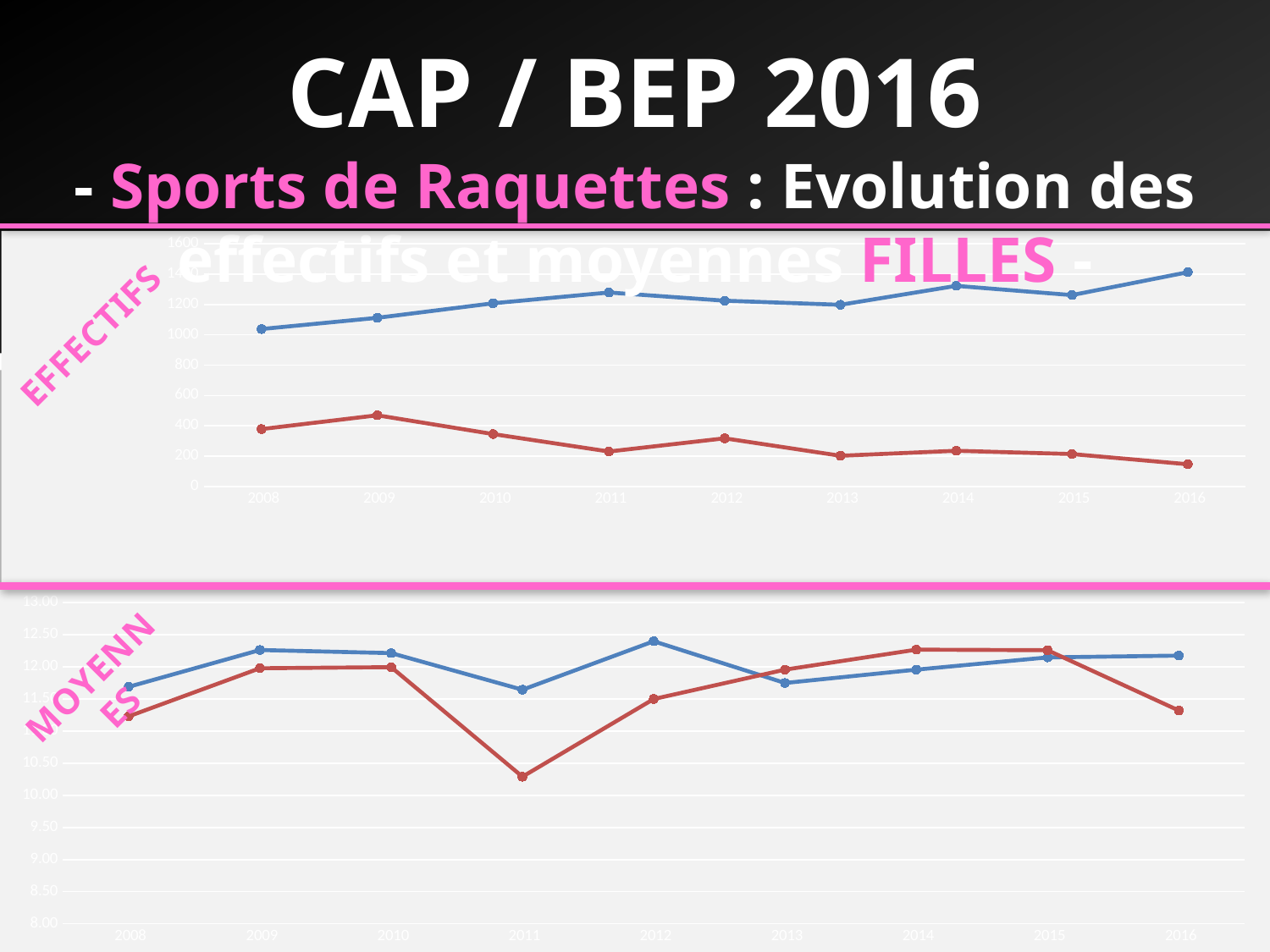
In the bottom chart (MOYENNES), in which year does the red line reach its lowest value? 2011 What kind of chart is the top chart (EFFECTIFS)? line chart How many years are shown on the x axis of the top chart (EFFECTIFS)? 9 In the bottom chart (MOYENNES), is the value of the red line for 2011 greater or less than 10.50? less In the top chart (EFFECTIFS), is the value of the blue line for 2008 greater or less than 1000? greater In the top chart (EFFECTIFS), in which year does the red line reach its highest value? 2009 In the top chart (EFFECTIFS), in which year does the blue line reach its highest value? 2016 In the top chart (EFFECTIFS), which line has the larger value in 2012, the blue line or the red line? the blue line In the top chart (EFFECTIFS), is the value of the red line for 2016 greater or less than 200? less What is the first year shown on the x axis of the bottom chart (MOYENNES)? 2008 In the bottom chart (MOYENNES), which line has the larger value in 2012, the blue line or the red line? the blue line